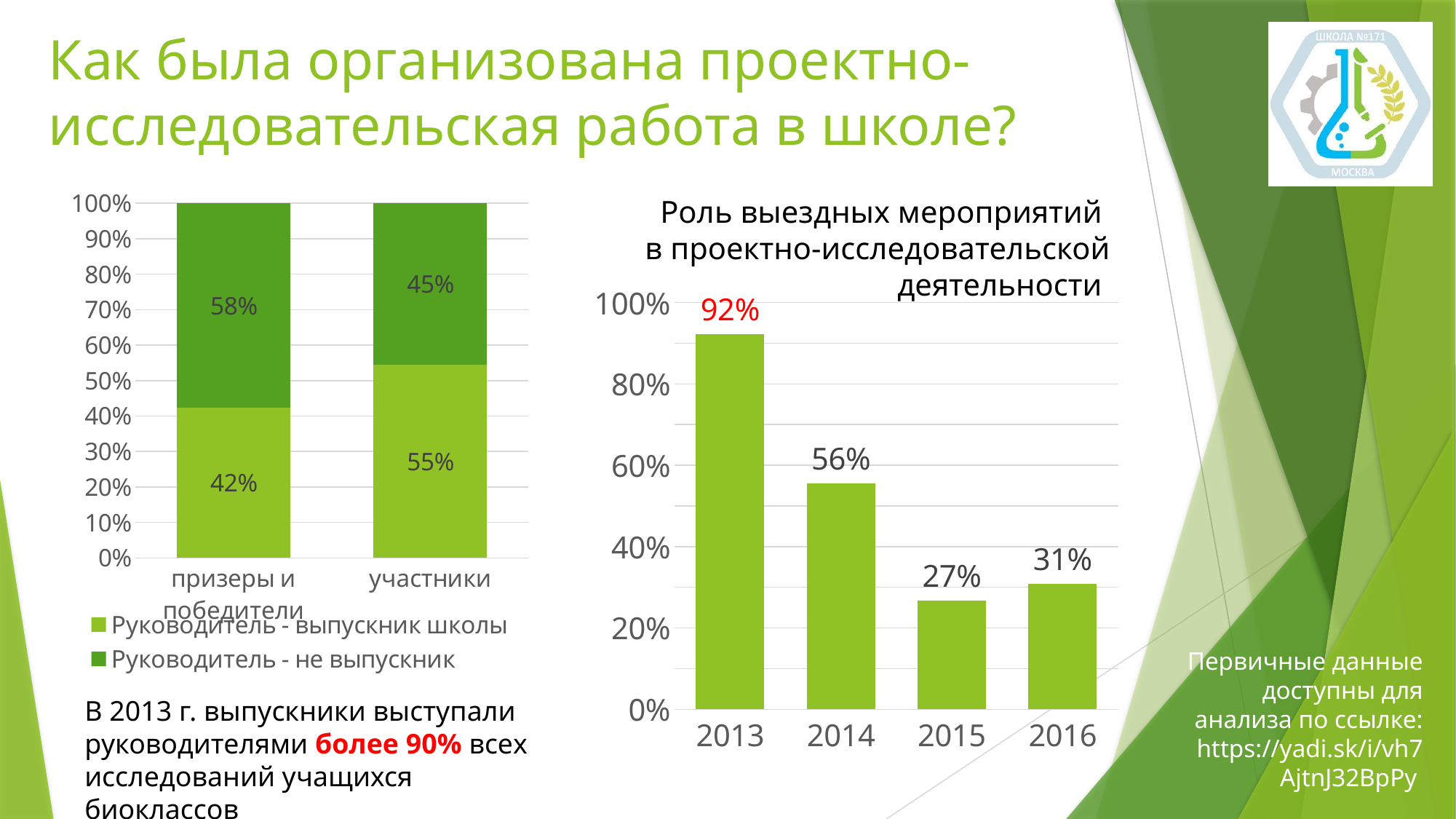
In the left-hand stacked bar chart, which is larger for "участники": "Руководитель - выпускник школы" or "Руководитель - не выпускник"? Руководитель - выпускник школы In the left-hand stacked bar chart, what is the value of "Руководитель - выпускник школы" for "призеры и победители"? 42% In the right-hand chart titled "Роль выездных мероприятий в проектно-исследовательской деятельности", what is the difference between the values for 2013 and 2014? 36% In the right-hand chart titled "Роль выездных мероприятий в проектно-исследовательской деятельности", which year has the lowest value? 2015 What kind of chart is the right-hand chart titled "Роль выездных мероприятий в проектно-исследовательской деятельности"? Bar chart In the left-hand stacked bar chart, what is the value of "Руководитель - не выпускник" for "участники"? 45% In the right-hand chart titled "Роль выездных мероприятий в проектно-исследовательской деятельности", what is the value for 2015? 27% How many years are shown on the x axis of the right-hand chart titled "Роль выездных мероприятий в проектно-исследовательской деятельности"? 4 In the right-hand chart titled "Роль выездных мероприятий в проектно-исследовательской деятельности", which is larger, the value for 2015 or the value for 2016? 2016 How many series does the legend of the left-hand stacked bar chart list? 2 In the right-hand chart titled "Роль выездных мероприятий в проектно-исследовательской деятельности", what is the value for 2013? 92% In the right-hand chart titled "Роль выездных мероприятий в проектно-исследовательской деятельности", which year has the highest value? 2013